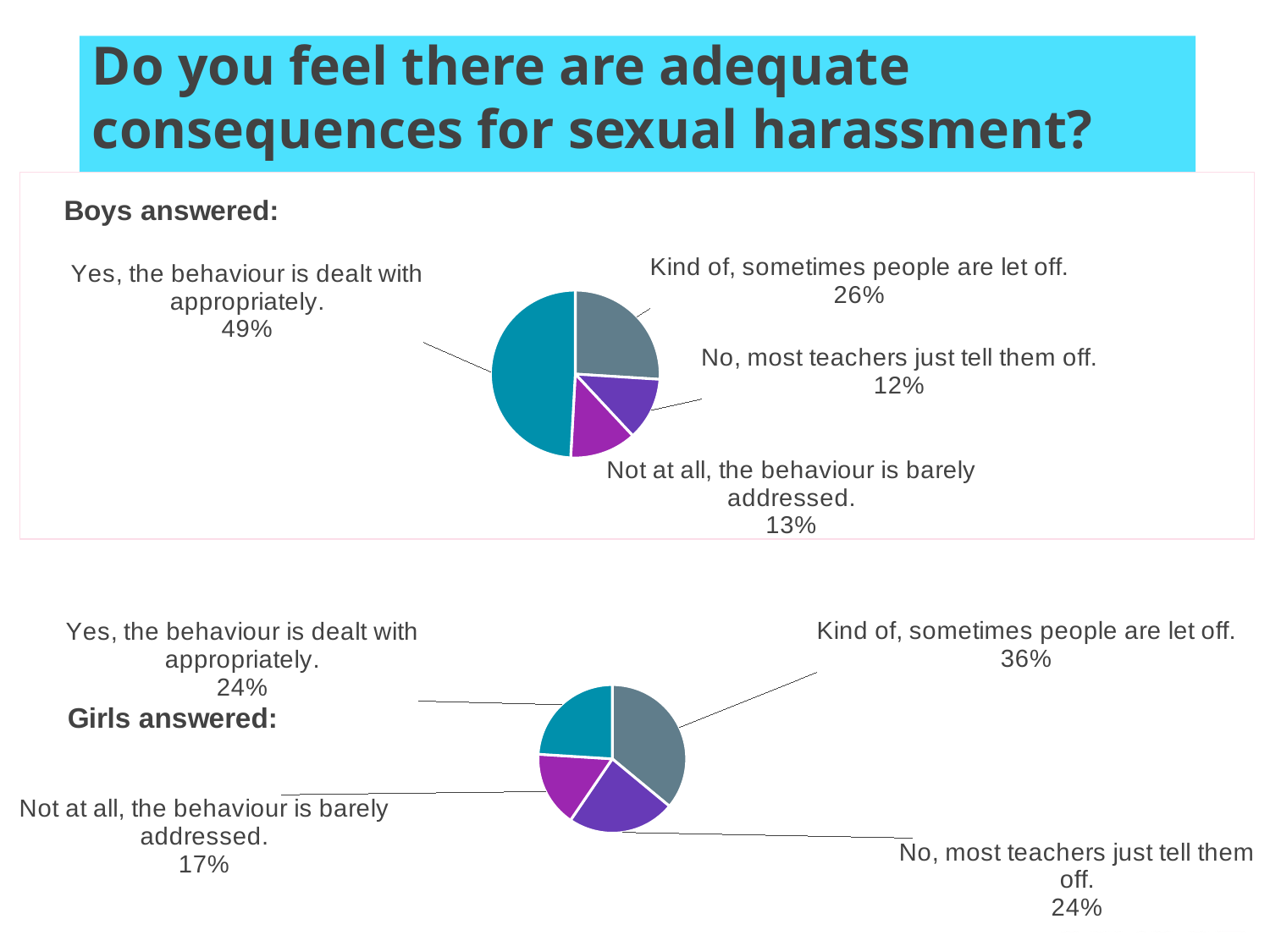
In the 'Girls answered' chart, which response has the smallest share? Not at all, the behaviour is barely addressed. In the 'Boys answered' chart, which response has the largest share? Yes, the behaviour is dealt with appropriately. In the 'Boys answered' chart, which response has the smallest share? No, most teachers just tell them off. How many response categories does the 'Girls answered' chart show? 4 In the 'Girls answered' chart, what share of girls answered 'Not at all, the behaviour is barely addressed'? 17% What type of chart is used for the 'Boys answered' data? Pie chart In the 'Girls answered' chart, what share of girls answered 'Kind of, sometimes people are let off'? 36% What is the difference between the share of boys and the share of girls who answered 'Yes, the behaviour is dealt with appropriately'? 25% In the 'Boys answered' chart, what share of boys answered 'Yes, the behaviour is dealt with appropriately'? 49% In the 'Girls answered' chart, which response has the largest share? Kind of, sometimes people are let off. Which is larger: the share of boys or the share of girls who answered 'Kind of, sometimes people are let off'? Girls In the 'Boys answered' chart, what share of boys answered 'No, most teachers just tell them off'? 12%